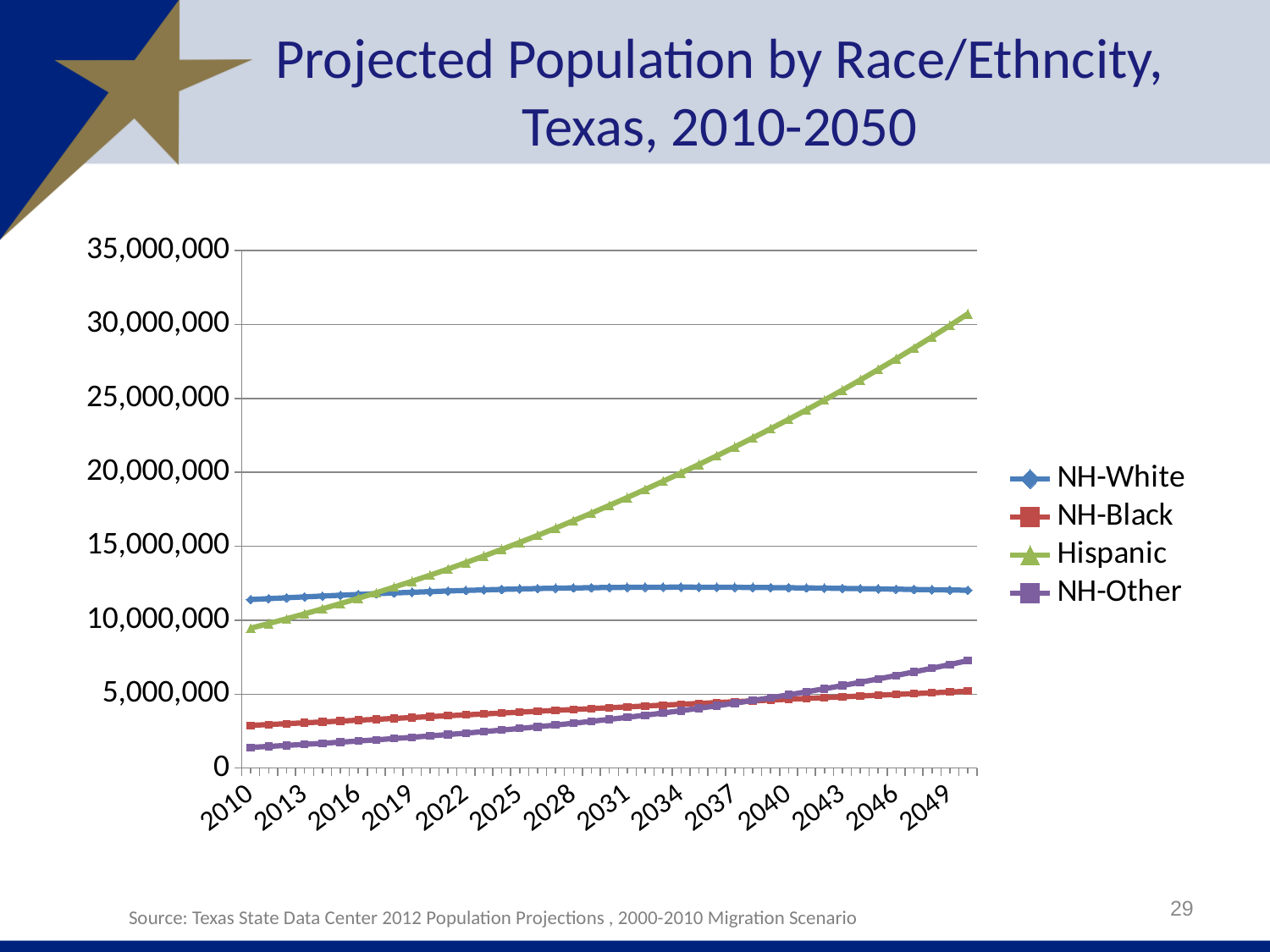
Is the Hispanic value for 2046 greater or less than 25,000,000? greater Which series has the lowest value in 2010? NH-Other What is the title of the chart? Projected Population by Race/Ethncity, Texas, 2010-2050 Is the NH-White value for 2010 greater or less than 10,000,000? greater In 2010, which is larger, NH-Black or NH-Other? NH-Black Which series has the highest value in 2049? Hispanic How many series does the legend list? 4 What kind of chart is shown on the slide? line chart Does the NH-Other population rise or fall from 2010 to 2050? rise Is the NH-Black value for 2010 greater or less than 5,000,000? less Does the Hispanic population rise or fall from 2010 to 2050? rise Which series is represented by the green line with triangle markers? Hispanic